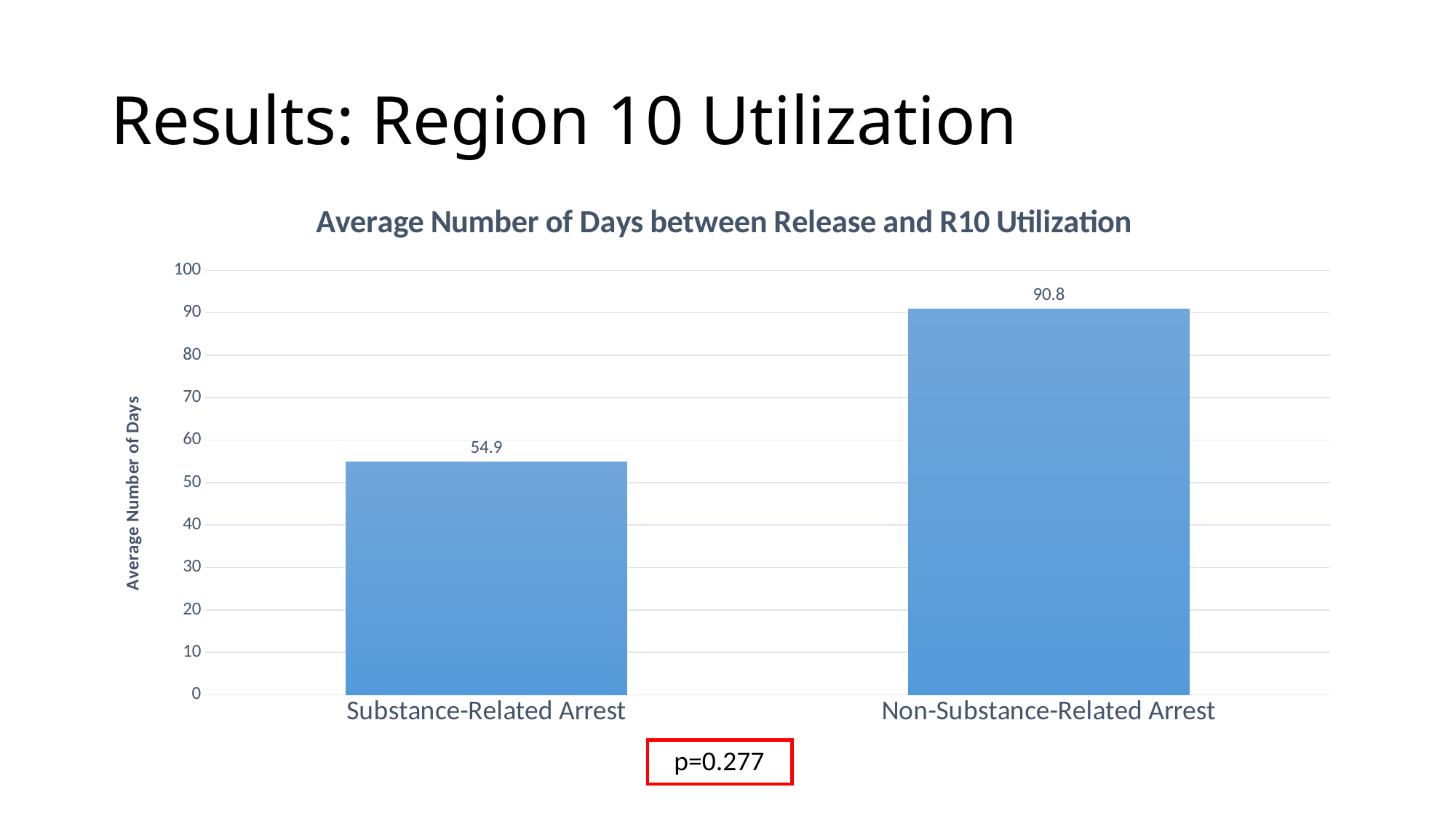
What is the difference in average number of days between Non-Substance-Related Arrest and Substance-Related Arrest? 35.9 Which category has the lowest average number of days? Substance-Related Arrest What kind of chart is shown on the slide? Bar chart Which is larger: the value for Substance-Related Arrest or the value for Non-Substance-Related Arrest? Non-Substance-Related Arrest Is the value for Non-Substance-Related Arrest greater or less than 80? greater How many categories are shown in the chart? 2 What is the average number of days between release and R10 utilization for Substance-Related Arrest? 54.9 What is the label of the vertical axis? Average Number of Days What is the title of the chart? Average Number of Days between Release and R10 Utilization What is the average number of days between release and R10 utilization for Non-Substance-Related Arrest? 90.8 Which category has the highest average number of days? Non-Substance-Related Arrest Is the value for Substance-Related Arrest greater or less than 60? less